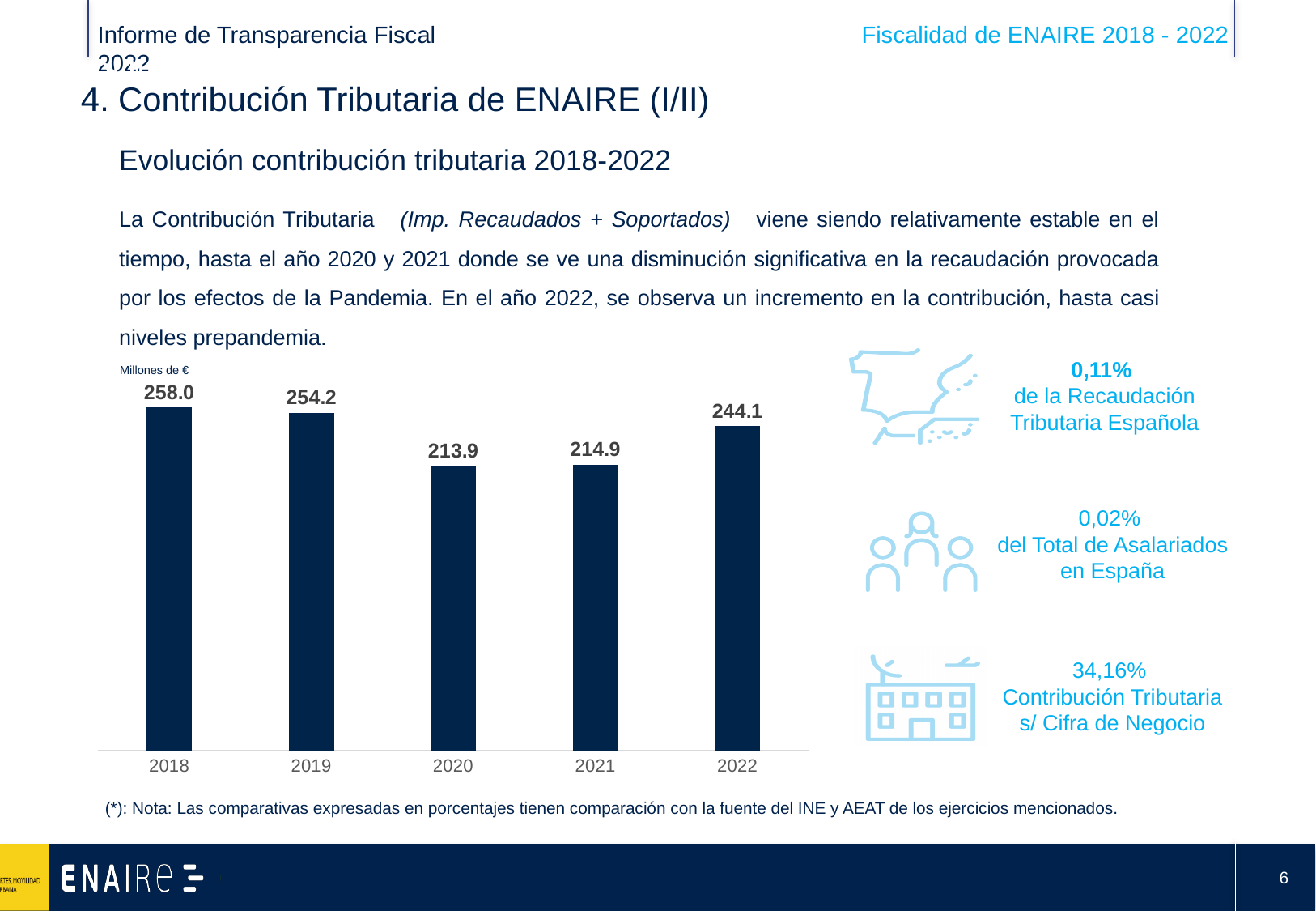
How many years are shown in the bar chart? 5 What unit is indicated above the bar chart? Millones de € What is the difference between the 2022 and 2021 values in the bar chart? 29.2 Do the values in the bar chart rise or fall from 2018 to 2020? fall What is the value for 2022 in the bar chart? 244.1 Which is larger in the bar chart, the value for 2019 or the value for 2022? 2019 Which year has the lowest value in the bar chart? 2020 What kind of chart is shown on the slide? bar chart What is the value for 2020 in the bar chart? 213.9 Which year has the highest value in the bar chart? 2018 What is the value for 2018 in the bar chart? 258.0 What is the difference between the 2018 and 2019 values in the bar chart? 3.8